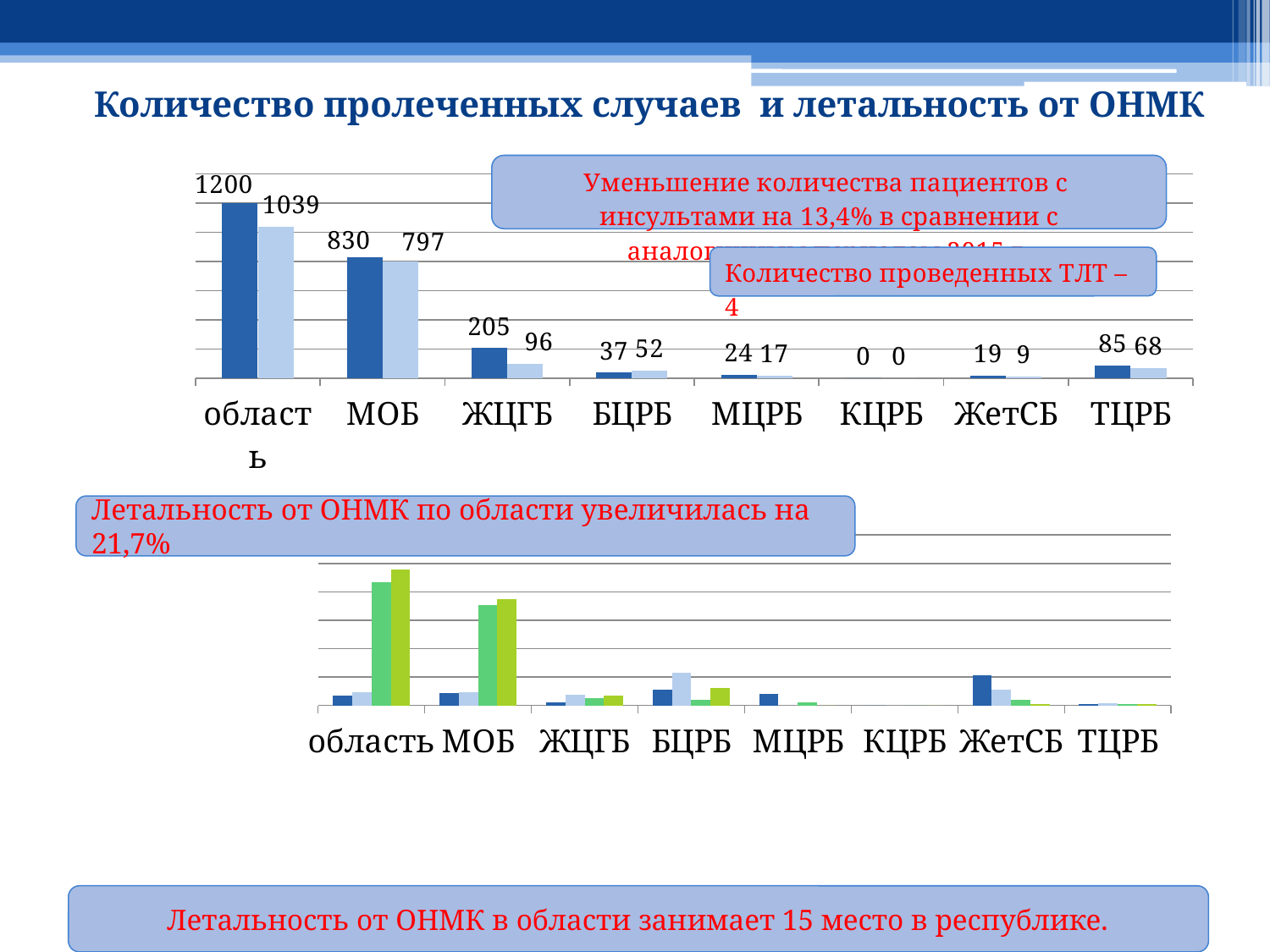
In the top chart, what is the value of the light blue bar for МОБ? 797 How many categories are shown on the x axis of the top chart? 8 What kind of chart is the top chart? bar chart In the top chart, which category has the lowest values, with both bars at 0? КЦРБ In the top chart, what is the value of the light blue bar for ТЦРБ? 68 In the top chart, what is the value of the dark blue bar for область? 1200 In the top chart, for БЦРБ, which bar is larger: the dark blue or the light blue? light blue In the bottom chart, which category has the tallest bar? область How many differently coloured bar series are plotted per category in the bottom chart? 4 In the top chart, what is the difference between the dark blue and light blue bars for область? 161 In the top chart, which category has the highest dark blue bar? область In the top chart, what is the value of the dark blue bar for ЖЦГБ? 205